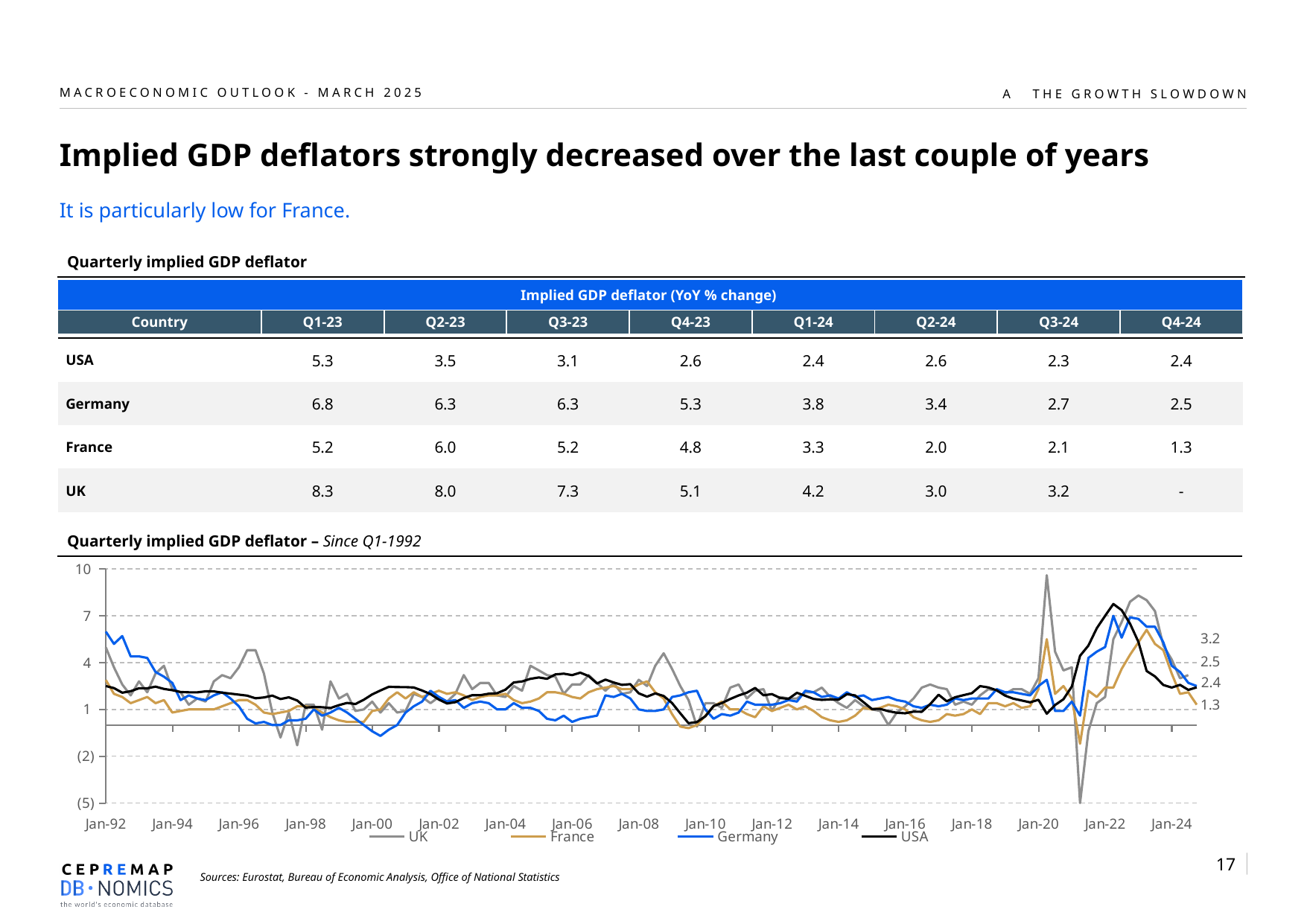
What kind of chart is shown under the heading "Quarterly implied GDP deflator – Since Q1-1992"? line chart In the line chart, which country has the highest value at the end of the series? UK In the line chart, what is the latest value labelled at the end of the UK line? 3.2 In the line chart, do the values for Germany rise or fall between Jan-22 and Jan-24? fall In the line chart, is the peak of the UK line around Jan-20 greater or less than 7? greater Which countries are listed in the legend of the line chart? UK, France, Germany, USA In the line chart, is the lowest point of the UK line around Jan-21 greater or less than (2)? less How many series does the legend of the line chart list? 4 In the line chart, what is the latest value labelled at the end of the France line? 1.3 In the line chart, what is the latest value labelled at the end of the USA line? 2.4 In the line chart, what is the difference between the end-of-series values for the UK and France? 1.9 In the line chart, which country has the lowest value at the end of the series? France